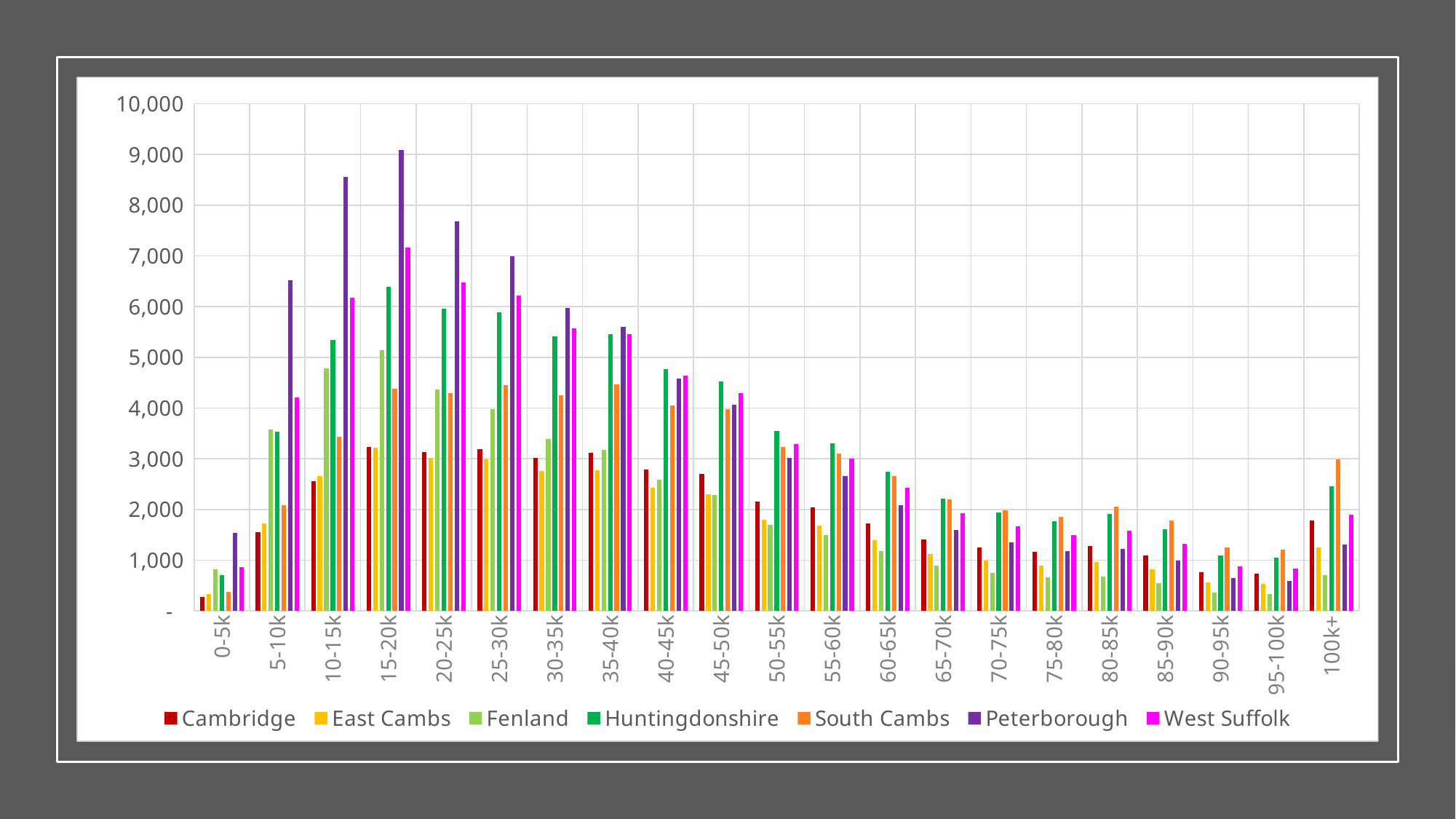
Is the value for Peterborough in the 15-20k category greater or less than 8,000? greater In which category does Peterborough reach its highest value? 15-20k Is the value for West Suffolk in the 15-20k category greater or less than 6,000? greater How many income band categories are shown on the x axis? 21 Which series has the highest bar in the 15-20k category? Peterborough Is the value for Huntingdonshire in the 40-45k category greater or less than 4,000? greater Which is larger in the 30-35k category: Huntingdonshire or East Cambs? Huntingdonshire How many series does the legend list? 7 What colour represents West Suffolk in the legend? magenta Do the Peterborough values rise or fall from the 15-20k category to the 95-100k category? fall What kind of chart is shown on the slide? bar chart